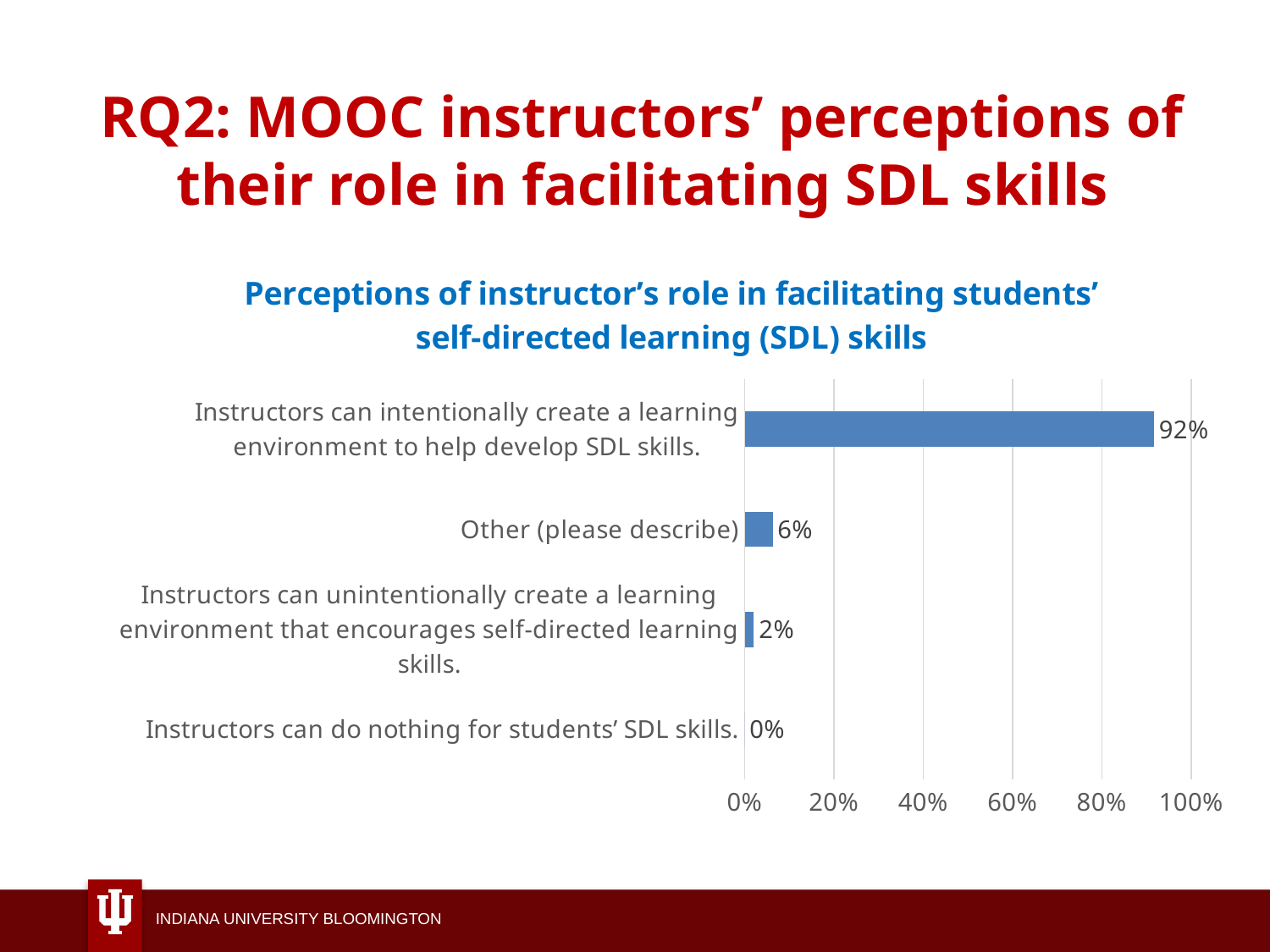
Is the value for "Instructors can intentionally create a learning environment to help develop SDL skills" greater or less than 80%? greater Which is larger: the percentage for "Other (please describe)" or for "Instructors can unintentionally create a learning environment that encourages self-directed learning skills"? Other (please describe) What is the title of the chart? Perceptions of instructor's role in facilitating students' self-directed learning (SDL) skills What percentage of instructors said they can unintentionally create a learning environment that encourages self-directed learning skills? 2% What is the difference in percentage points between the "intentionally create" category and the "Other (please describe)" category? 86 percentage points What percentage of respondents chose "Other (please describe)"? 6% How many categories are shown in the chart? 4 What type of chart is shown on the slide? Bar chart Which category has the lowest percentage? Instructors can do nothing for students' SDL skills. Which category has the highest percentage? Instructors can intentionally create a learning environment to help develop SDL skills. What percentage of instructors said they can do nothing for students' SDL skills? 0% What percentage of instructors said they can intentionally create a learning environment to help develop SDL skills? 92%